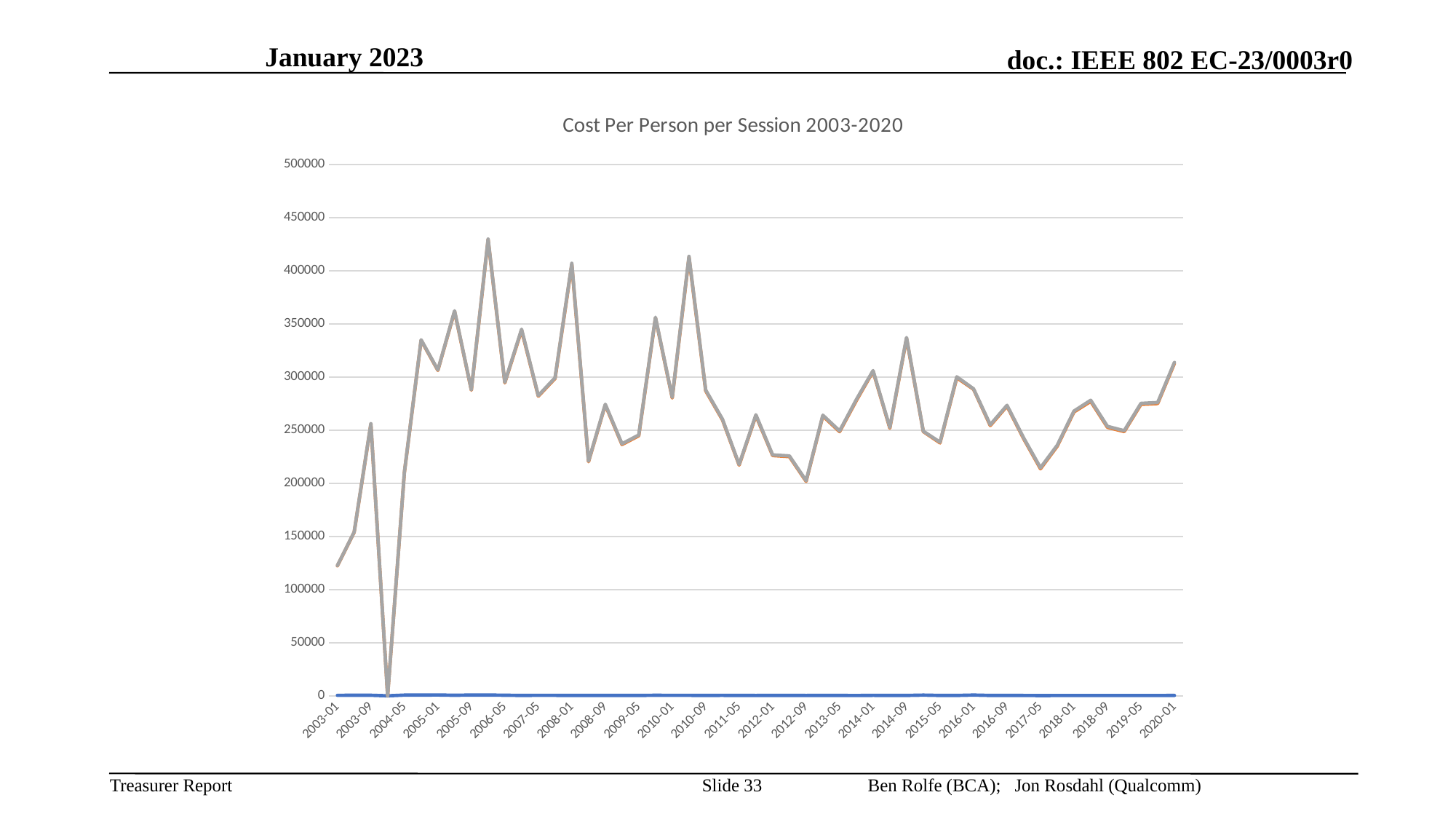
Is the value for 2020-01 greater or less than 300000? greater What is the title of the chart? Cost Per Person per Session 2003-2020 Is the value for 2011-05 greater or less than 250000? less Is the value for 2008-01 greater or less than 350000? greater Which has the larger value, 2020-01 or 2003-01? 2020-01 What is the highest value shown on the vertical axis? 500000 Which has the larger value, 2008-01 or 2012-09? 2008-01 What kind of chart is shown on the slide? line chart Among the labelled dates, which has the lowest value? 2003-01